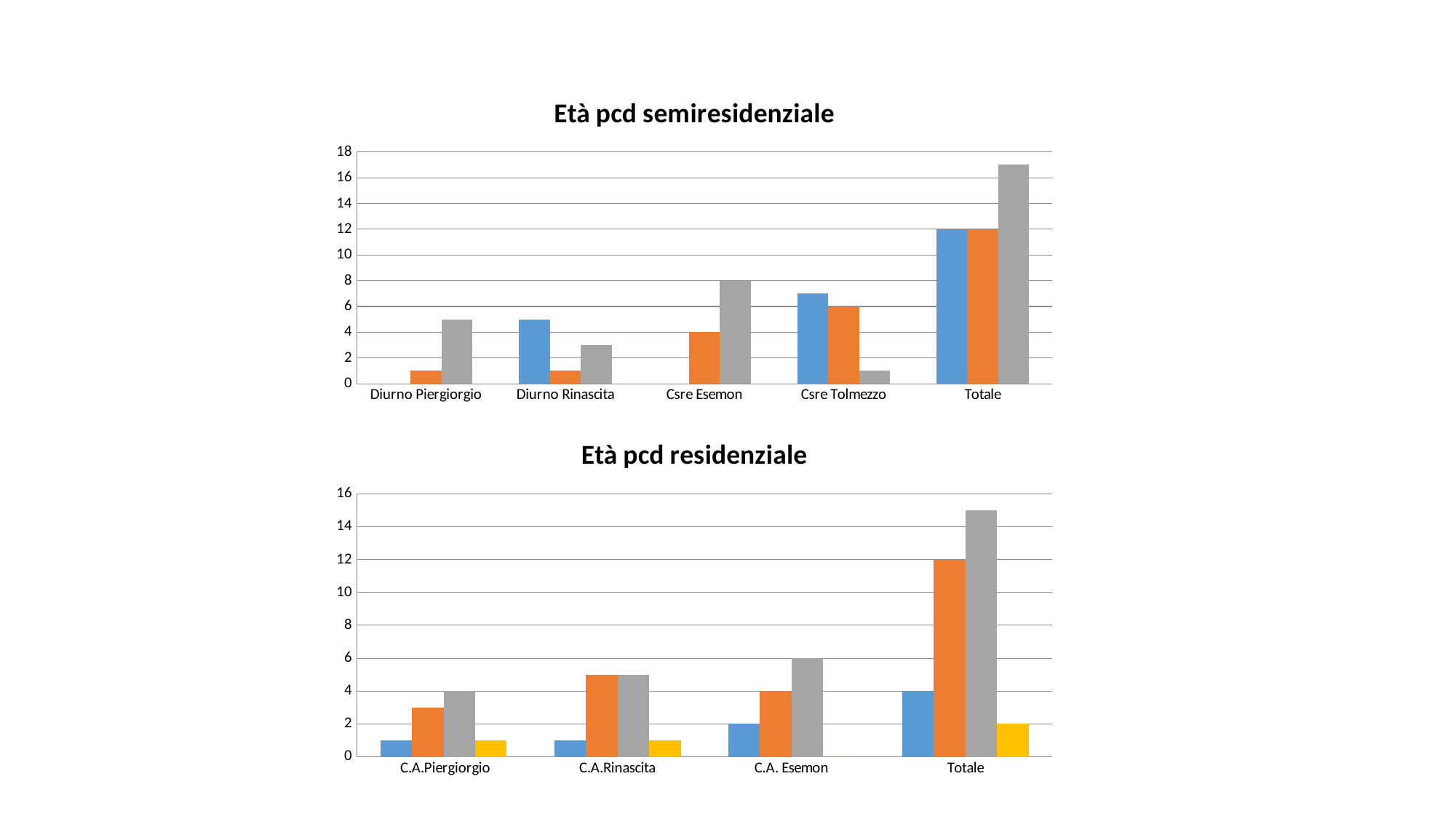
In the 'Età pcd residenziale' chart, what is the value of the orange bar for Totale? 12 In the 'Età pcd residenziale' chart, is the gray bar for Totale greater or less than 14? greater In the 'Età pcd semiresidenziale' chart, is the gray bar for Totale greater or less than 16? greater In the 'Età pcd semiresidenziale' chart, what is the value of the gray bar for Csre Esemon? 8 In the 'Età pcd residenziale' chart, what is the value of the gray bar for C.A. Esemon? 6 How many categories are shown on the x axis of the 'Età pcd semiresidenziale' chart? 5 In the 'Età pcd semiresidenziale' chart, what is the value of the blue bar for Totale? 12 How many categories are shown on the x axis of the 'Età pcd residenziale' chart? 4 In the 'Età pcd semiresidenziale' chart, which is larger for Csre Esemon: the orange bar or the gray bar? the gray bar In the 'Età pcd residenziale' chart, what is the value of the yellow bar for Totale? 2 In the 'Età pcd semiresidenziale' chart, which category has the tallest bar overall? Totale What kind of chart is 'Età pcd semiresidenziale'? bar chart